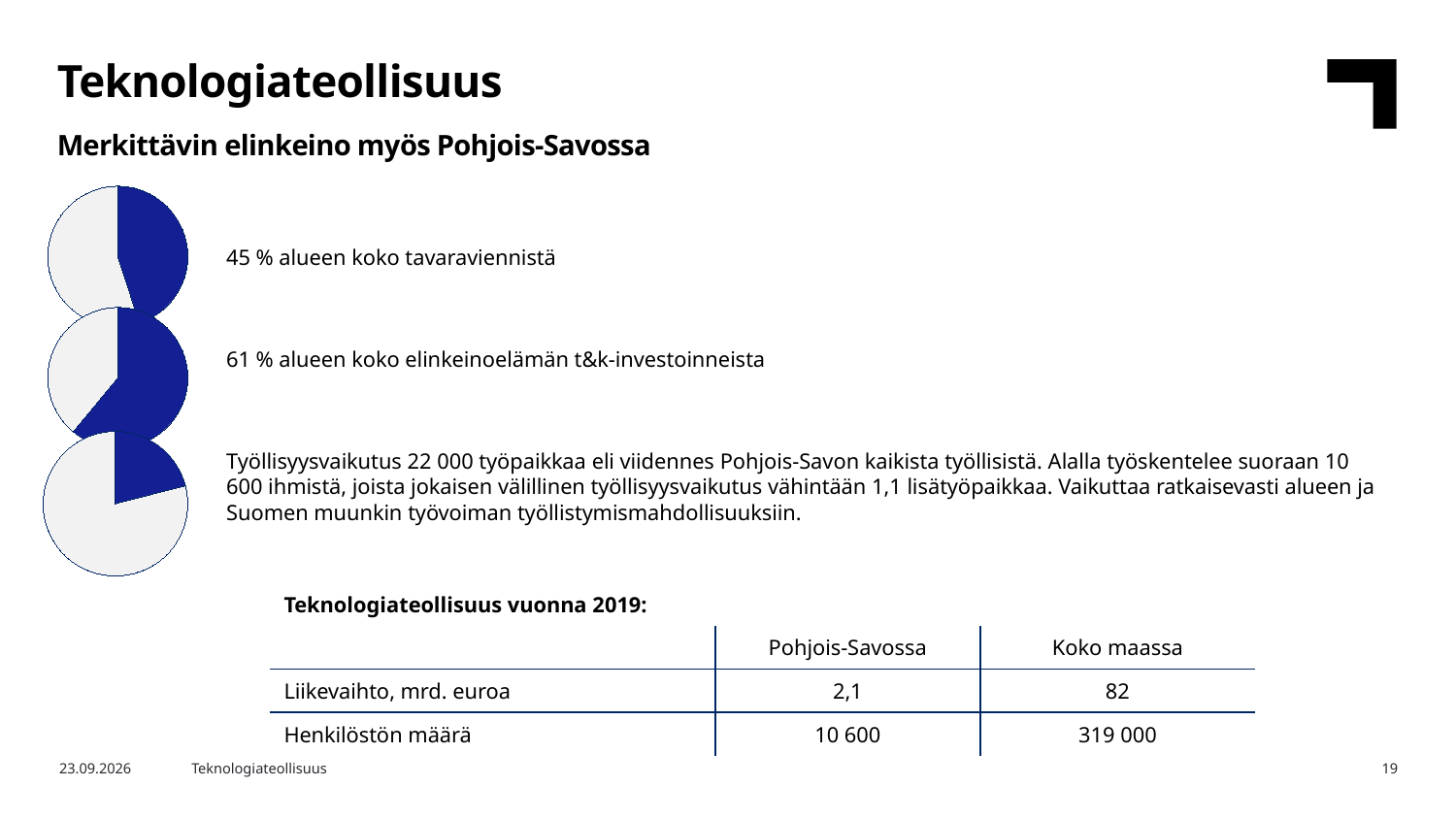
What kind of charts are shown on the left side of the slide? Pie charts How many pie charts are on the slide? 3 Which pie chart has the smallest dark blue slice: the top, middle or bottom one? Bottom According to the text next to the top pie chart, what share of the region's total goods exports does the dark blue slice represent? 45 % According to the text next to the middle pie chart, what share of the region's business R&D investments does the dark blue slice represent? 61 % Is the dark blue slice in the bottom pie chart greater or less than 50% of the pie? less Which pie chart has the largest dark blue slice: the top, middle or bottom one? Middle What colour is used for the highlighted slice in each pie chart? Dark blue Is the dark blue slice in the top pie chart larger or smaller than the dark blue slice in the middle pie chart? Smaller How many slices does each pie chart have? 2 Is the dark blue slice in the middle pie chart greater or less than 50% of the pie? greater